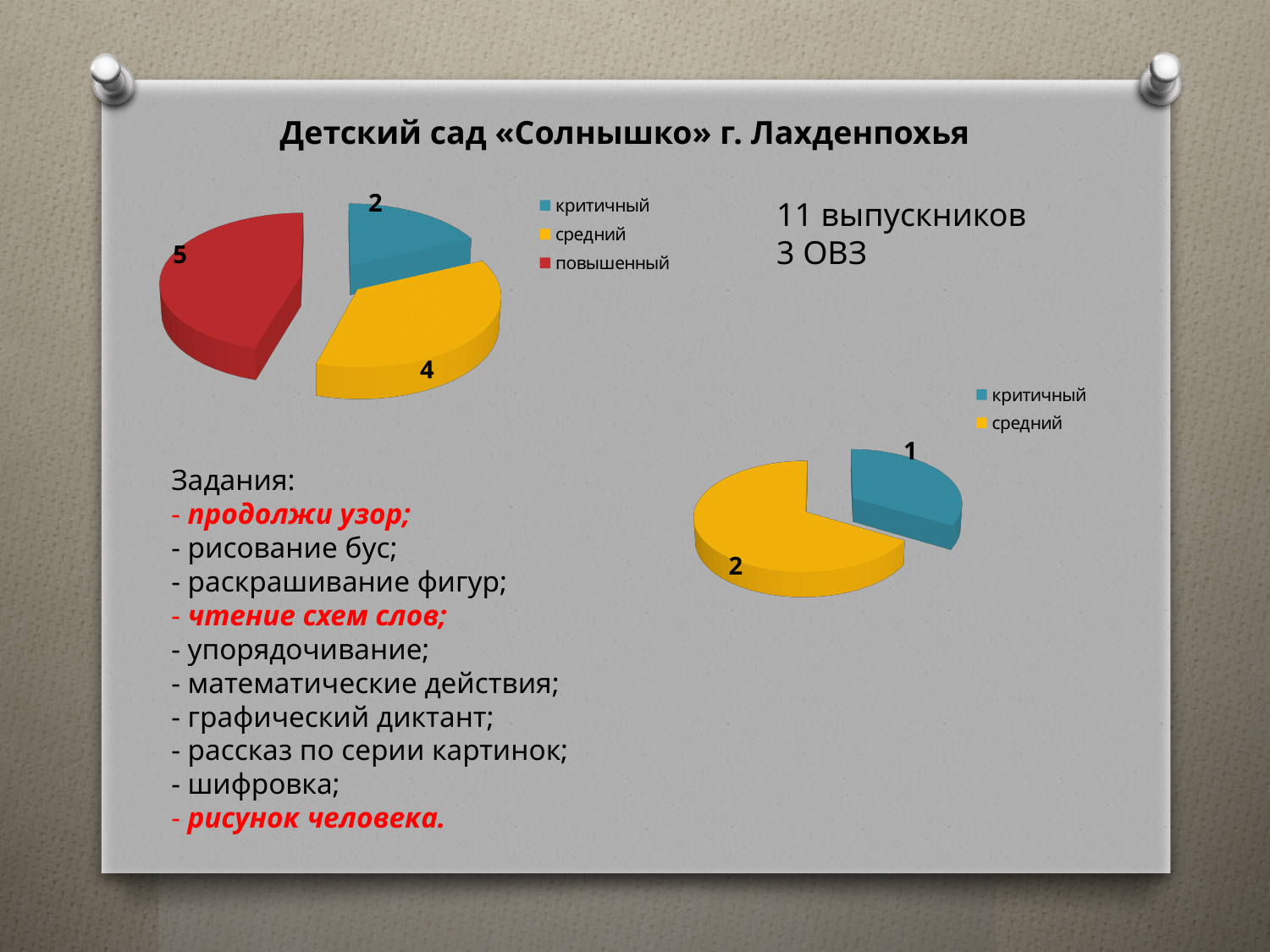
What type of chart is shown at the top left of the slide? Pie chart In the pie chart at the bottom right of the slide, which is larger, 'критичный' or 'средний'? средний In the pie chart at the top left of the slide, what is the difference between the 'повышенный' and 'критичный' values? 3 In the pie chart at the top left of the slide, which category has the largest slice? повышенный In the pie chart at the bottom right of the slide, what value is shown for the 'средний' slice? 2 In the pie chart at the bottom right of the slide, what value is shown for the 'критичный' slice? 1 In the pie chart at the top left of the slide, which category has the smallest slice? критичный In the pie chart at the top left of the slide, what value is shown for the 'средний' slice? 4 In the pie chart at the bottom right of the slide, how many categories does the legend list? 2 In the pie chart at the top left of the slide, how many categories does the legend list? 3 In the pie chart at the top left of the slide, what value is shown for the 'повышенный' slice? 5 In the pie chart at the top left of the slide, what value is shown for the 'критичный' slice? 2